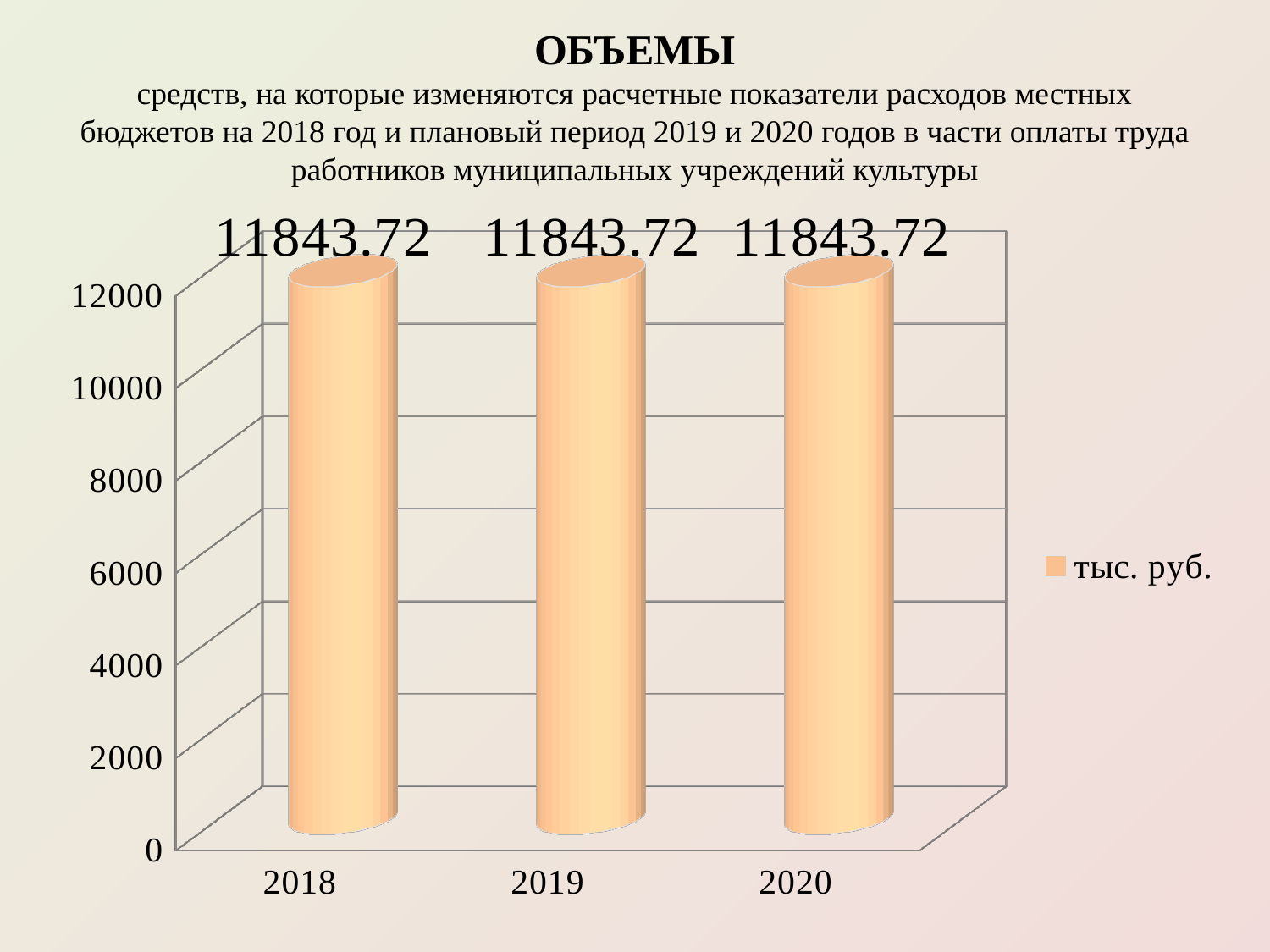
How many years are shown on the x axis? 3 Is the value for 2019 greater or less than 10000? greater What is the value for 2018? 11843.72 How many series does the legend list? 1 What is the highest tick value shown on the vertical axis? 12000 Is the value for 2020 greater or less than 12000? less What is the legend entry for the series? тыс. руб. What kind of chart is shown on the slide? bar chart Do the values rise, fall or stay the same from 2018 to 2020? stay the same What is the value for 2020? 11843.72 What is the value for 2019? 11843.72 What is the difference between the values for 2018 and 2020? 0